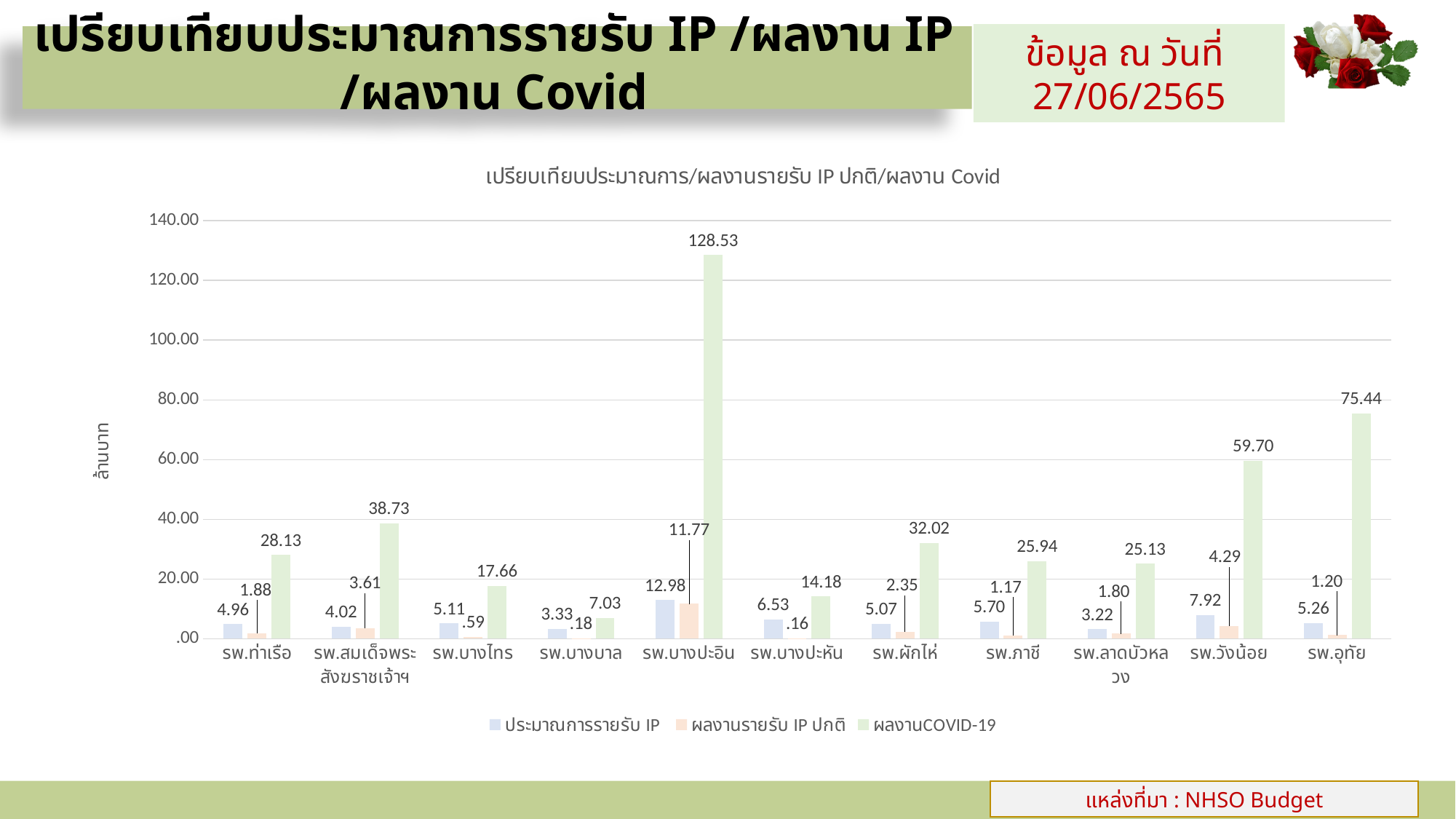
Which hospital has the lowest ผลงานCOVID-19 value? รพ.บางบาล What kind of chart is shown on the slide? bar chart What is the ผลงานCOVID-19 value for รพ.บางปะอิน? 128.53 Which is larger, the ประมาณการรายรับ IP value for รพ.บางปะหัน or for รพ.ภาชี? รพ.บางปะหัน What is the ผลงานรายรับ IP ปกติ value for รพ.สมเด็จพระสังฆราชเจ้าฯ? 3.61 Is the ผลงานCOVID-19 value for รพ.ผักไห่ greater or less than 40.00? less How many hospitals are shown on the x axis? 11 Which hospital has the highest ผลงานCOVID-19 value? รพ.บางปะอิน What is the difference between the ผลงานCOVID-19 values for รพ.อุทัย and รพ.วังน้อย? 15.74 How many series does the legend list? 3 What is the y-axis label of the chart? ล้านบาท What is the ประมาณการรายรับ IP value for รพ.วังน้อย? 7.92